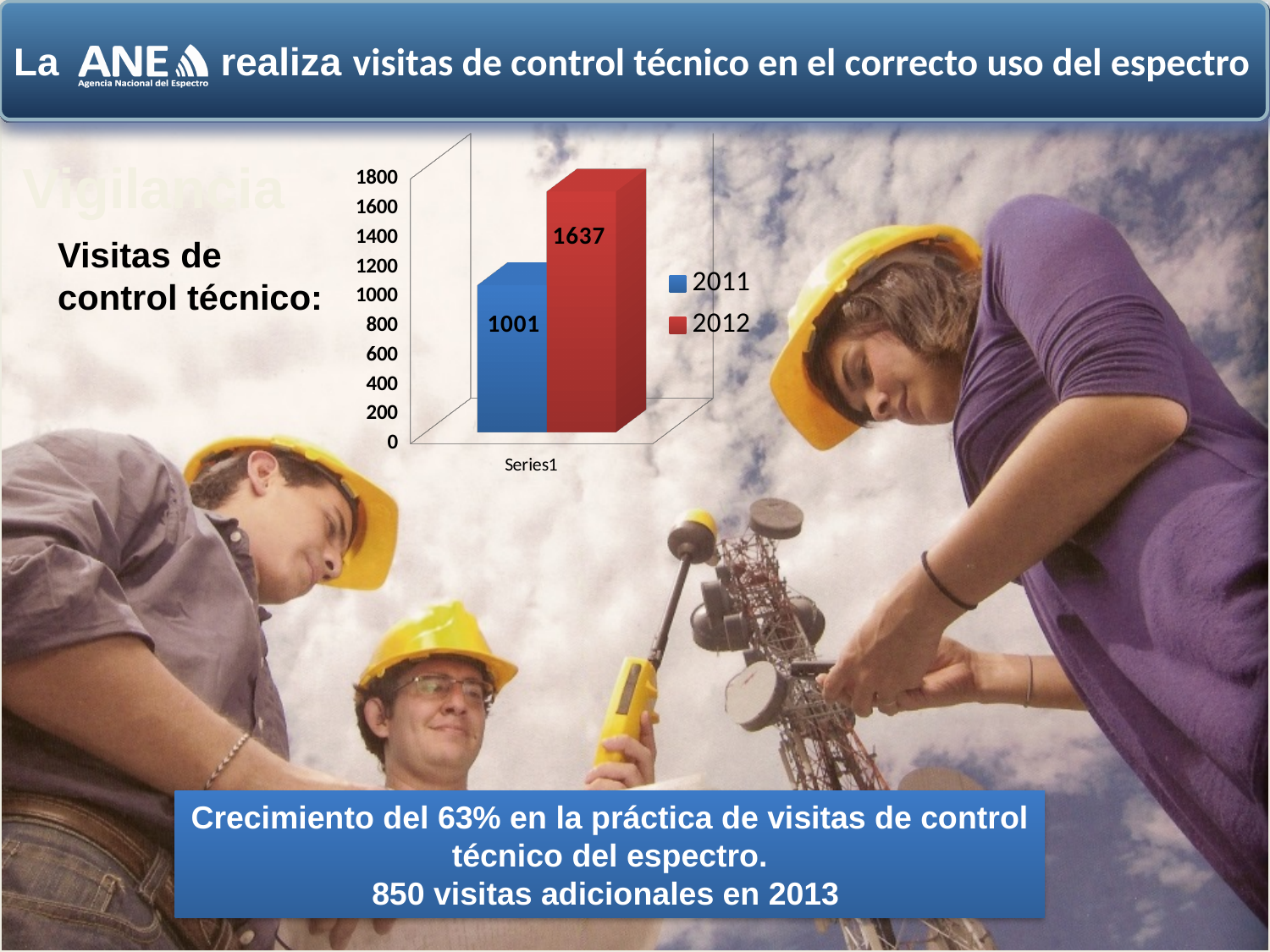
What is the value for 2012 in the chart? 1637 Is the value for 2012 greater or less than 1400? greater What is the value for 2011 in the chart? 1001 Which year has the lower value in the chart? 2011 What is the label shown on the x axis of the chart? Series1 Is the value for 2011 greater or less than 1200? less Is the value for 2012 larger or smaller than the value for 2011? larger How many series does the chart legend list? 2 Which year has the higher value in the chart? 2012 What is the difference between the 2012 and 2011 values in the chart? 636 What colour is the bar for 2012 in the chart? red What kind of chart is shown on the slide? bar chart